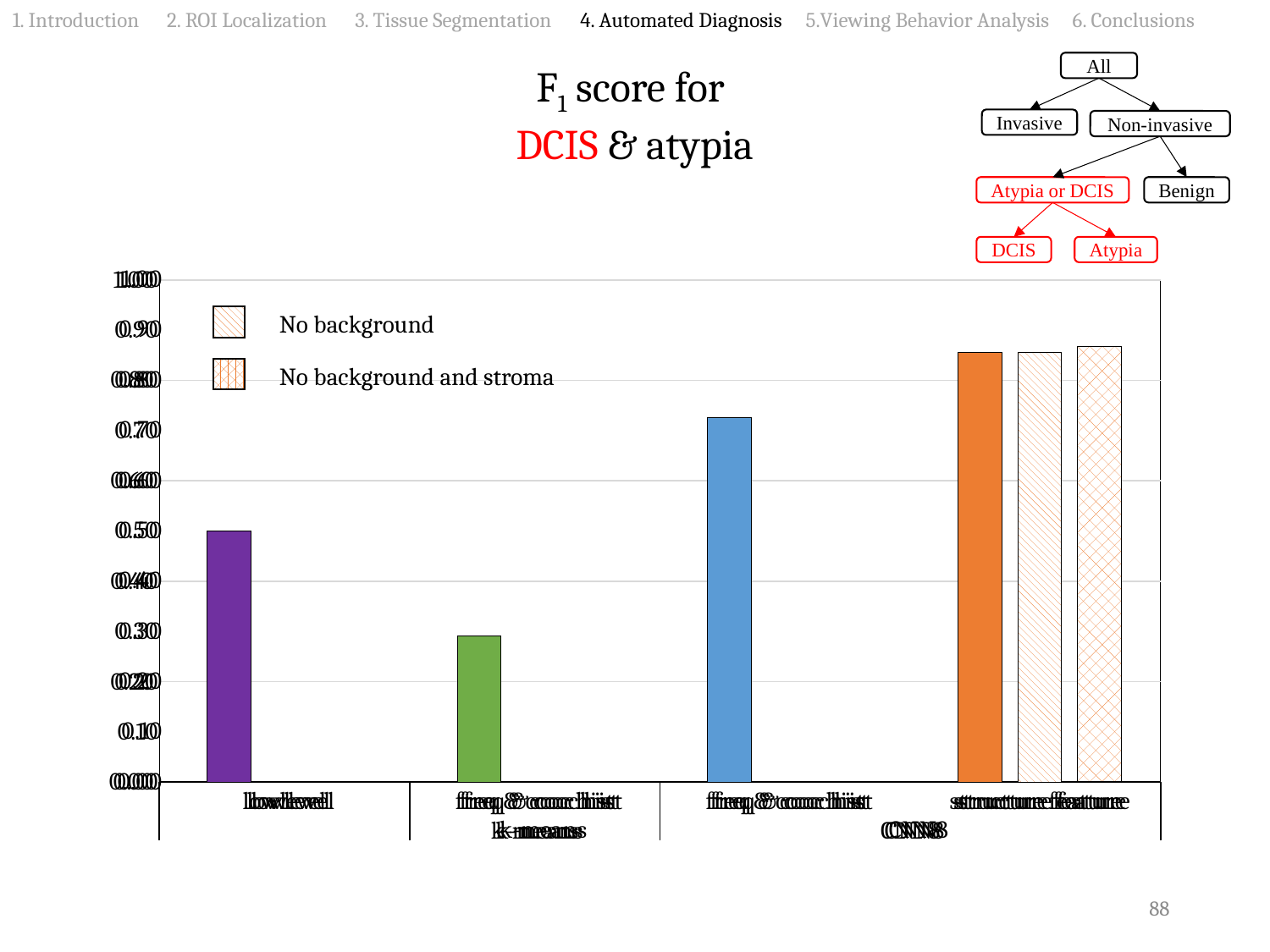
Is the F1 score for low level greater or less than 0.40? greater What is the title of the chart? F1 score for DCIS & atypia How many entries does the chart's legend list? 2 Is the F1 score for freq & cooc hist k-means greater or less than 0.40? less How many categories are shown along the x axis of the chart? 4 Which category has the lowest F1 score in the chart? freq & cooc hist k-means What kind of chart is shown on the slide? bar chart Which has a larger F1 score: low level or freq & cooc hist CNNs? freq & cooc hist CNNs Which category has the highest F1 score in the chart? structure feature Is the F1 score for the solid orange structure feature bar greater or less than 0.80? greater How many bars are plotted in the chart in total? 6 Which has a larger F1 score: low level or freq & cooc hist k-means? low level